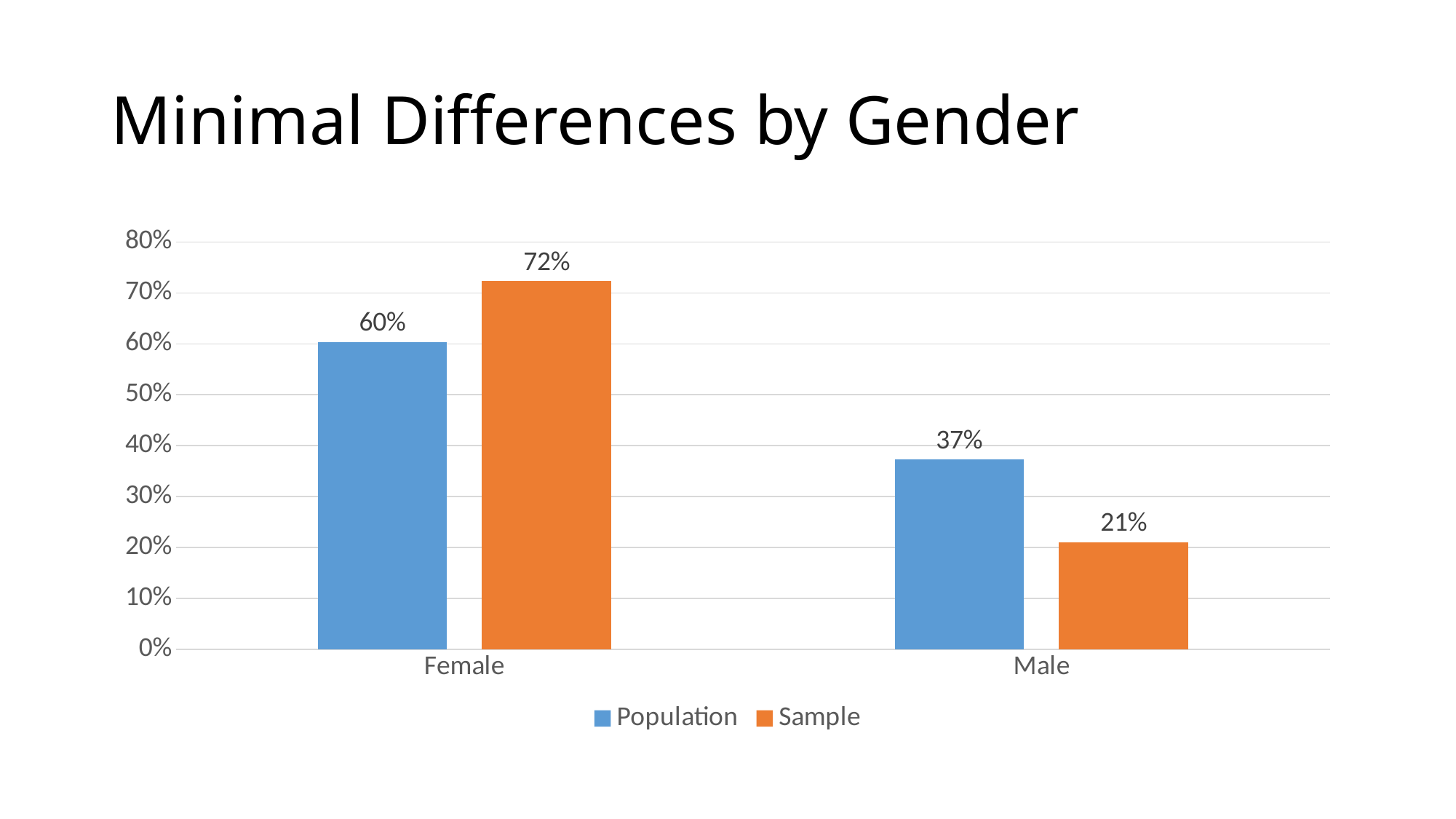
What is the Population value for Male? 37% What is the Sample value for Male? 21% What is the difference between the Sample and Population values for Female? 12% What kind of chart is shown on the slide? Bar chart What is the Population value for Female? 60% Which category has the lowest Population value? Male What is the difference between the Population and Sample values for Male? 16% How many categories are shown on the x axis? 2 How many series does the legend list? 2 For Male, which is larger: the Population value or the Sample value? Population Which category has the highest Sample value? Female What is the Sample value for Female? 72%